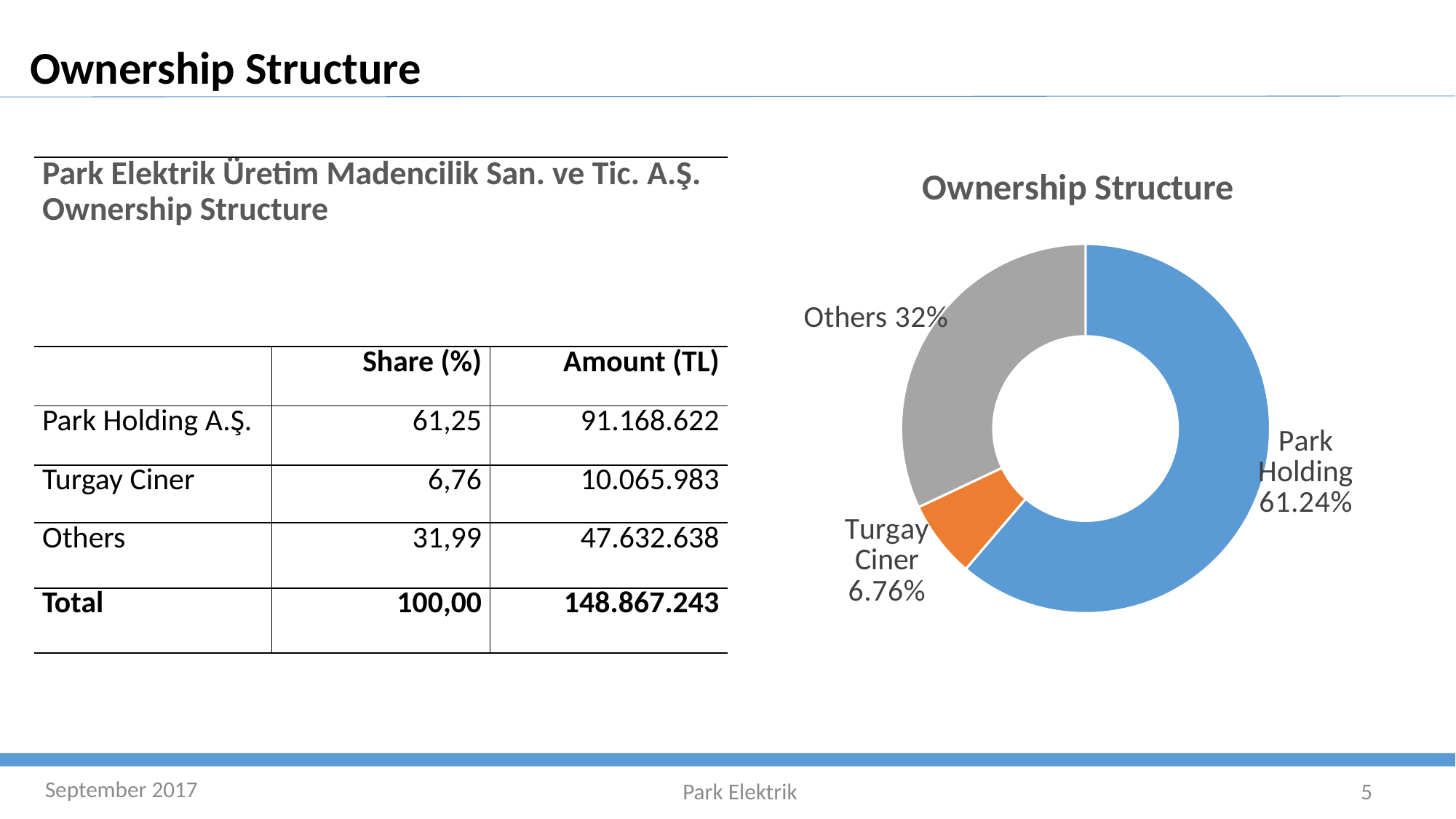
What share does the chart show for Others? 32% What share does the chart show for Turgay Ciner? 6.76% What colour is the Turgay Ciner slice in the chart? orange What share does the chart show for Park Holding? 61.24% Which is larger in the chart, the share of Others or the share of Turgay Ciner? Others What is the difference between the Park Holding share and the Turgay Ciner share in the chart? 54.48% Which shareholder has the smallest share in the chart? Turgay Ciner What is the title of the chart? Ownership Structure How many slices does the chart have? 3 What is the difference between the Park Holding share and the Others share in the chart? 29.24% What kind of chart is shown on the slide? doughnut chart Which shareholder has the largest share in the chart? Park Holding